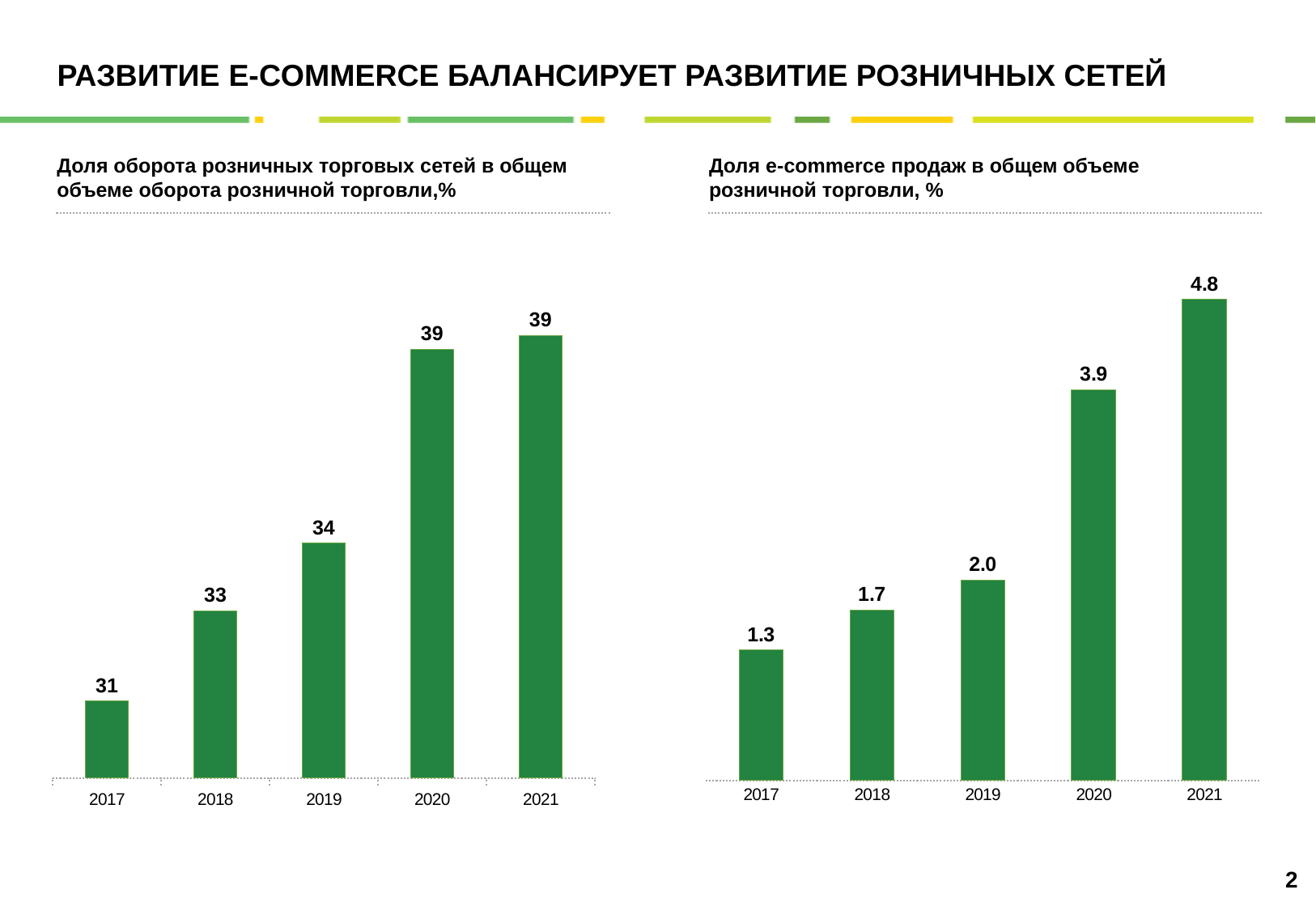
In the right chart, which is larger: the value for 2019 or the value for 2018? 2019 In the left chart, what is the value for 2021? 39 In the right chart, which year has the highest value? 2021 What type of chart is the right chart? bar chart How many years are shown on the x axis of the left chart? 5 In the right chart (share of e-commerce sales in total retail turnover), what is the value for 2020? 3.9 In the right chart, what is the difference between the values for 2021 and 2017? 3.5 What is the title of the right chart? Доля e-commerce продаж в общем объеме розничной торговли, % In the left chart, which year has the lowest value? 2017 In the right chart, do the values rise or fall from 2017 to 2021? rise In the left chart, what is the difference between the values for 2020 and 2018? 6 In the left chart (share of retail chains' turnover in total retail turnover), what is the value for 2019? 34